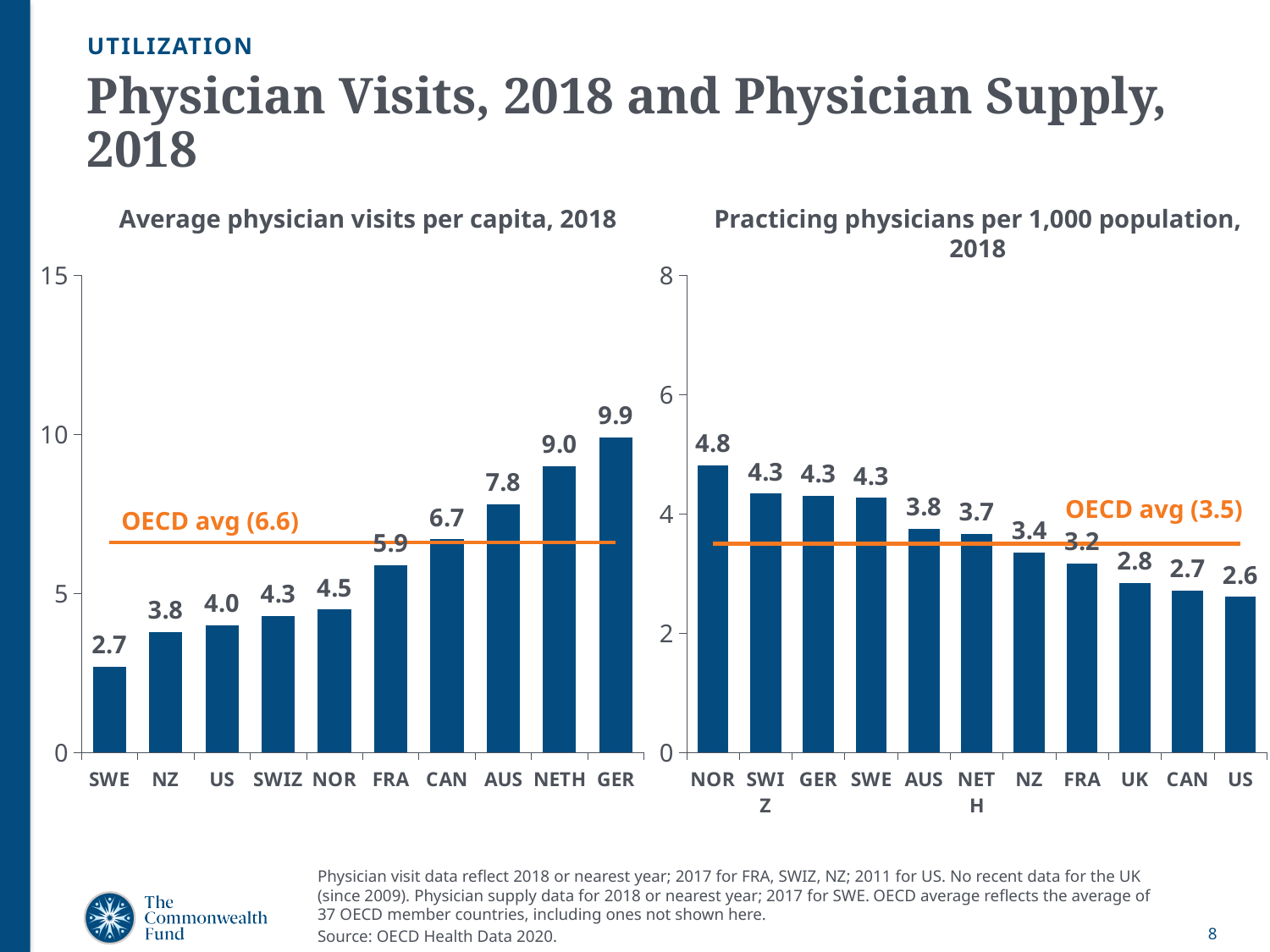
In the 'Average physician visits per capita, 2018' chart, which is larger, the value for NETH or the value for AUS? NETH What kind of chart is the 'Practicing physicians per 1,000 population, 2018' chart? bar chart In the 'Practicing physicians per 1,000 population, 2018' chart, what is the difference between NOR and US? 2.2 In the 'Average physician visits per capita, 2018' chart, which country has the highest value? GER In the 'Average physician visits per capita, 2018' chart, what is the difference between GER and SWE? 7.2 How many countries are shown in the 'Practicing physicians per 1,000 population, 2018' chart? 11 In the 'Practicing physicians per 1,000 population, 2018' chart, what is the value for AUS? 3.8 How many countries are shown in the 'Average physician visits per capita, 2018' chart? 10 What OECD average is marked by the orange line in the 'Average physician visits per capita, 2018' chart? 6.6 In the 'Practicing physicians per 1,000 population, 2018' chart, which country has the lowest value? US In the 'Average physician visits per capita, 2018' chart, what is the value for CAN? 6.7 In the 'Practicing physicians per 1,000 population, 2018' chart, is the value for NZ greater or less than 4? less